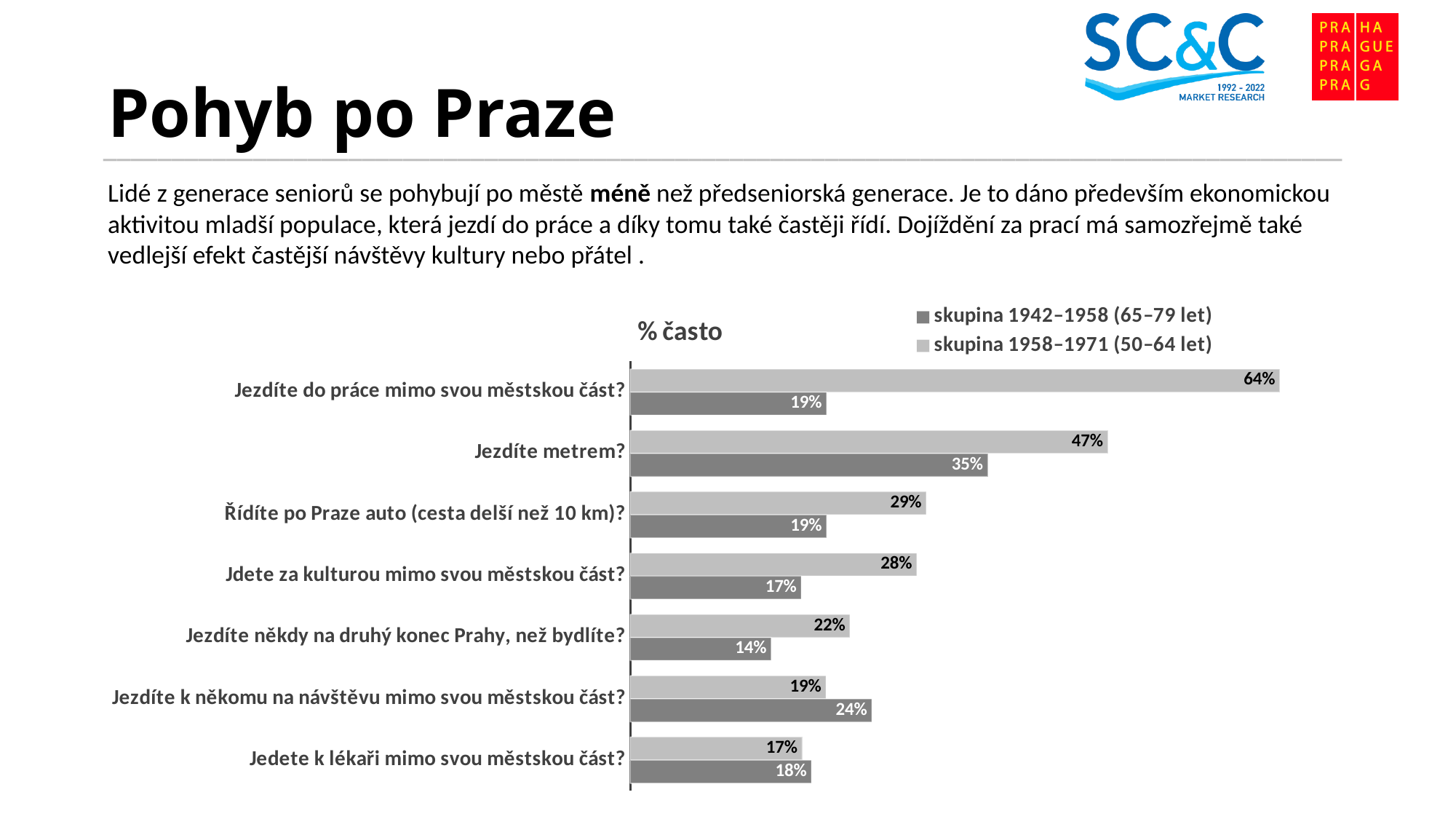
Which category has the highest value for the series 'skupina 1958–1971 (50–64 let)'? Jezdíte do práce mimo svou městskou část? What is the value for 'Jezdíte metrem?' for the series 'skupina 1942–1958 (65–79 let)'? 35% How many series does the legend list? 2 What kind of chart is shown on the slide? Bar chart Which category has the lowest value for the series 'skupina 1942–1958 (65–79 let)'? Jezdíte někdy na druhý konec Prahy, než bydlíte? What is the difference between the two series for 'Jezdíte metrem?'? 12% For 'Jedete k lékaři mimo svou městskou část?', which series has the larger value? skupina 1942–1958 (65–79 let) What is the title of the chart? % často What is the difference between the two series for 'Jezdíte do práce mimo svou městskou část?'? 45% What is the value for 'Jezdíte do práce mimo svou městskou část?' for the series 'skupina 1958–1971 (50–64 let)'? 64% What is the value for 'Jezdíte k někomu na návštěvu mimo svou městskou část?' for the series 'skupina 1942–1958 (65–79 let)'? 24% How many categories are shown in the chart? 7